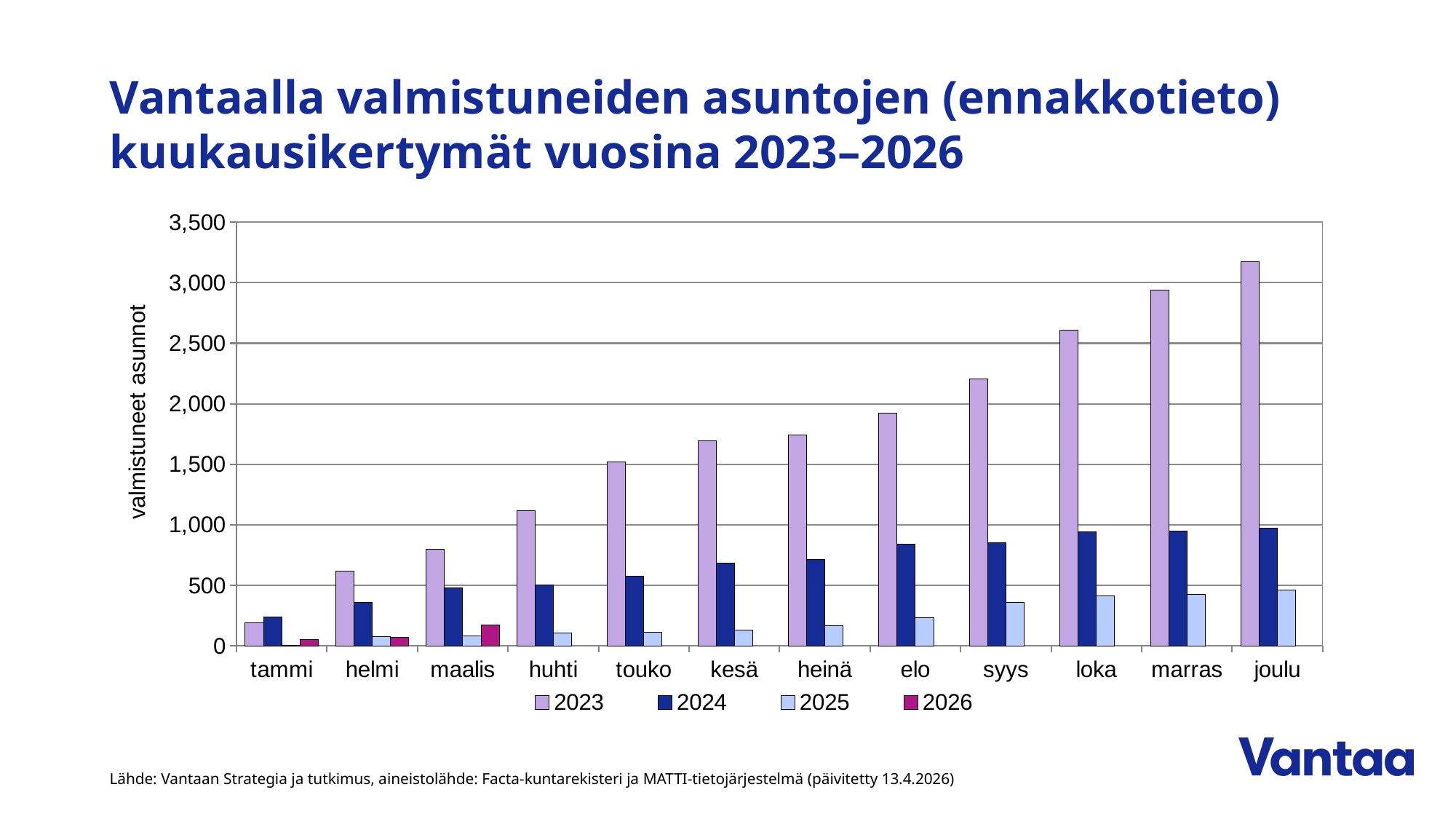
Is the 2026 value for maalis greater or less than 500? less What kind of chart is shown on the slide? bar chart For maalis, which series has the larger value, 2025 or 2026? 2026 Do the 2023 values rise or fall from tammi to joulu? rise What is the label on the y axis? valmistuneet asunnot How many series does the legend list? 4 For tammi, which series has the larger value, 2023 or 2024? 2024 For the 2023 series, which month has the highest value? joulu Is the 2023 value for syys greater or less than 2,000? greater How many month categories are shown on the x axis? 12 Is the 2023 value for joulu greater or less than 3,000? greater